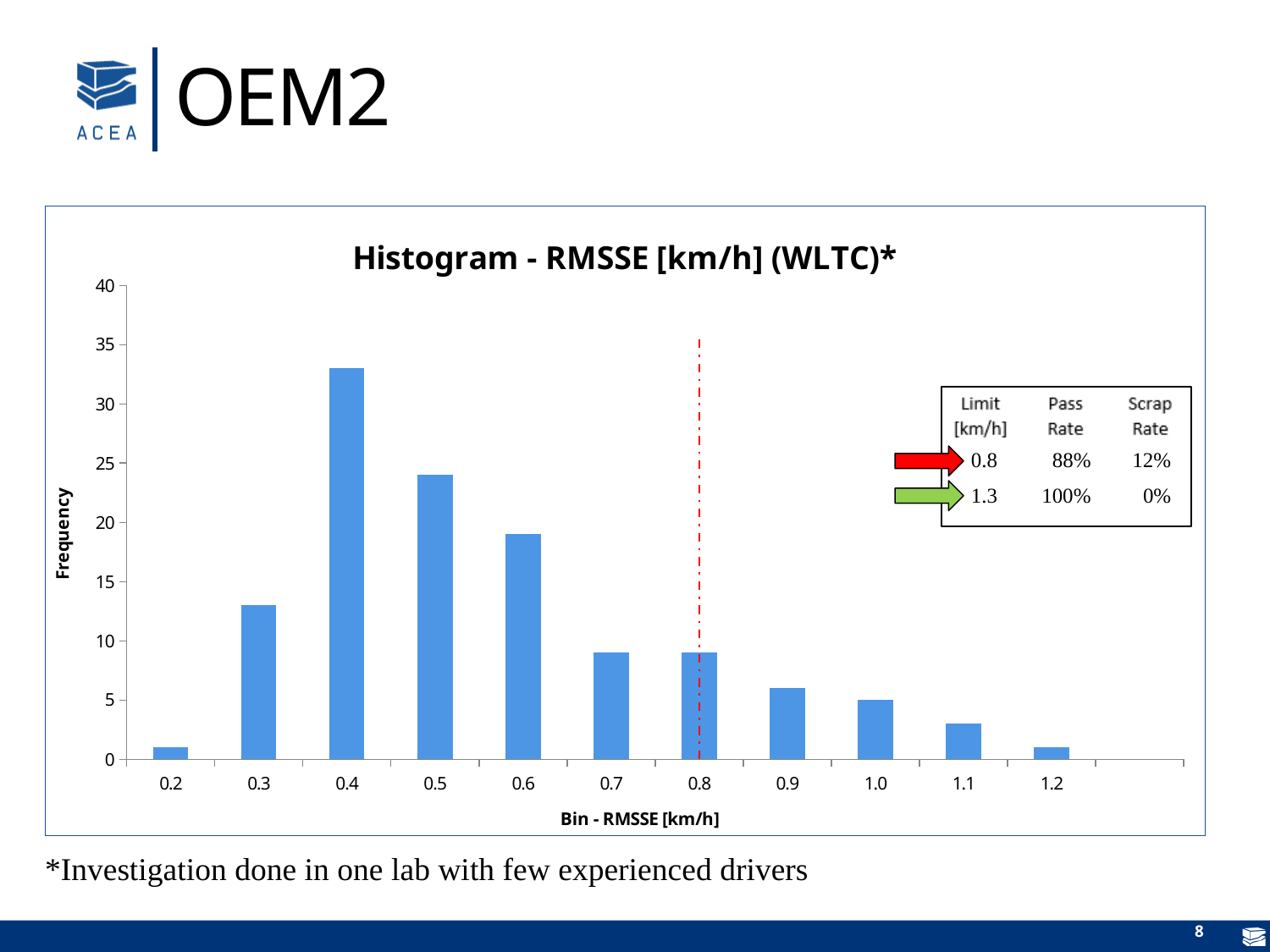
Which bin has the higher frequency, 0.3 or 0.5? 0.5 What kind of chart is shown on the slide? bar chart Is the frequency for bin 0.5 greater or less than 20? greater Is the frequency for bin 1.1 greater or less than 5? less What is the label of the y axis? Frequency How many bins have bars in the histogram? 11 Which bin has the highest frequency? 0.4 Is the frequency for bin 0.7 greater or less than 10? less Which bin has the higher frequency, 0.6 or 0.9? 0.6 What is the title of the chart? Histogram - RMSSE [km/h] (WLTC)*